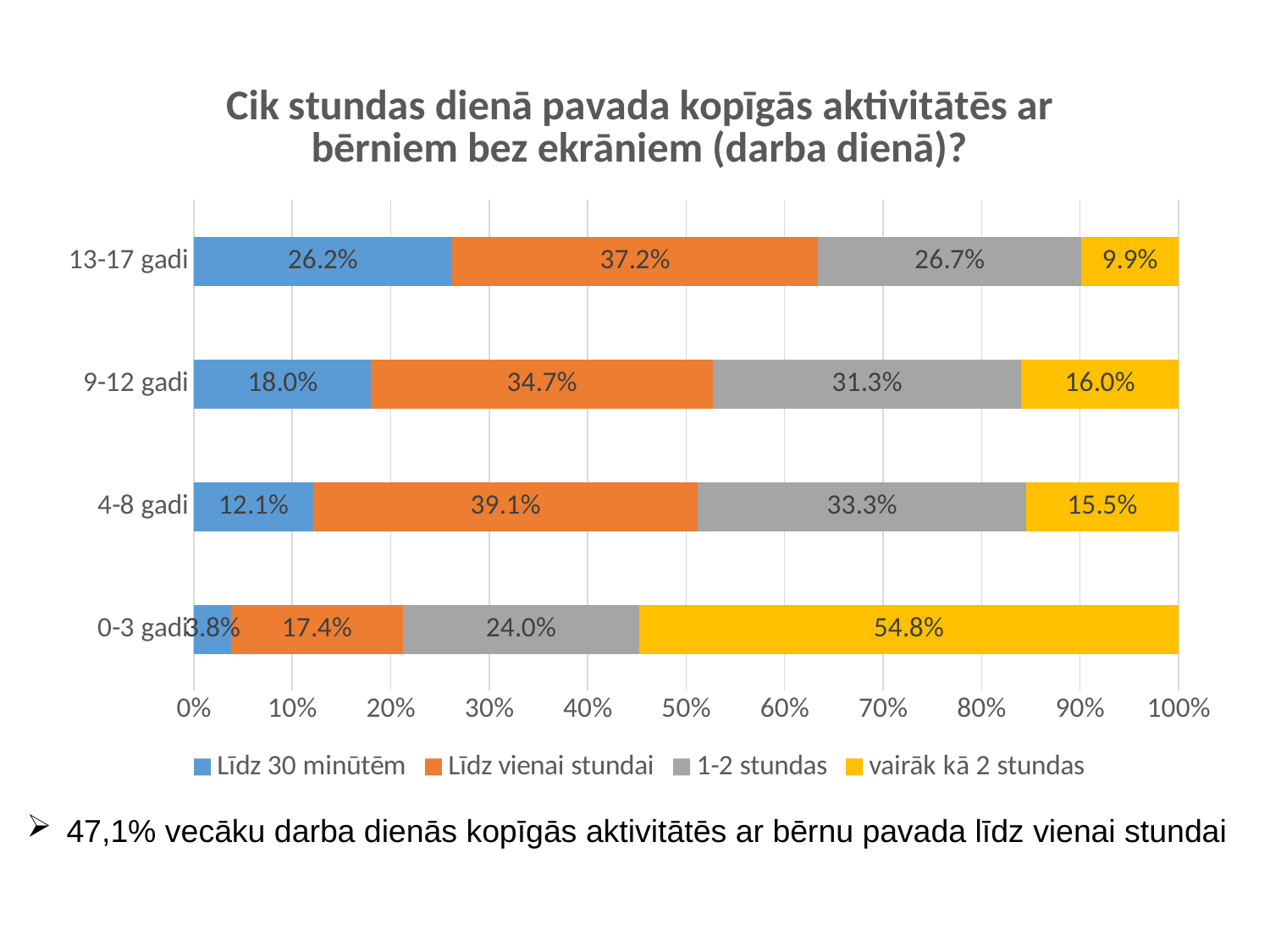
What is the value for 'Līdz vienai stundai' in the 13-17 gadi group? 37.2% What is the difference between the 'Līdz vienai stundai' values for 4-8 gadi and 9-12 gadi? 4.4% Which series is shown in orange in the legend? Līdz vienai stundai Which is larger: the '1-2 stundas' value for 4-8 gadi or for 13-17 gadi? 4-8 gadi What is the value for 'Līdz 30 minūtēm' in the 4-8 gadi group? 12.1% How many series does the legend list? 4 Which age group has the highest value for 'vairāk kā 2 stundas'? 0-3 gadi How many age groups are shown on the chart? 4 What is the value for '1-2 stundas' in the 9-12 gadi group? 31.3% Which age group has the lowest value for 'Līdz 30 minūtēm'? 0-3 gadi What is the value for 'vairāk kā 2 stundas' in the 0-3 gadi group? 54.8% What kind of chart is shown on the slide? stacked bar chart